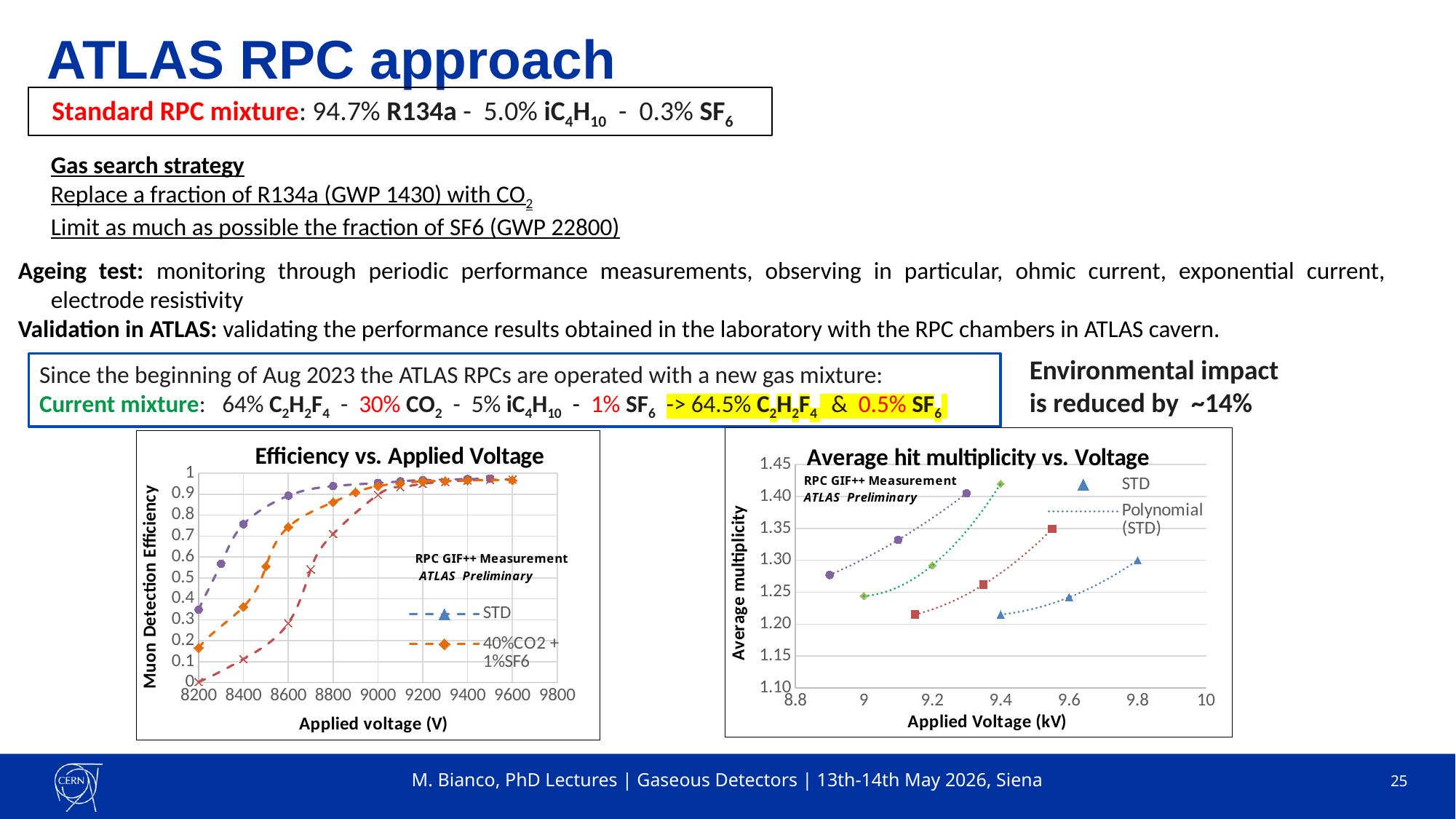
In the Efficiency vs. Applied Voltage chart, is the efficiency of the orange 40%CO2 + 1%SF6 series at 8600 V greater or less than 0.5? greater What is the title of the chart on the left of the slide? Efficiency vs. Applied Voltage What is the title of the chart on the right of the slide? Average hit multiplicity vs. Voltage In the Efficiency vs. Applied Voltage chart, is the efficiency of the orange 40%CO2 + 1%SF6 series at 8400 V greater or less than 0.5? less In the Average hit multiplicity vs. Voltage chart, is the red square series value at about 9.55 kV greater or less than 1.30? greater In the Efficiency vs. Applied Voltage chart, does the efficiency rise or fall as the applied voltage increases? rise In the Average hit multiplicity vs. Voltage chart, does the average multiplicity rise or fall as the applied voltage increases? rise In the Efficiency vs. Applied Voltage chart, what is the label of the y axis? Muon Detection Efficiency In the Average hit multiplicity vs. Voltage chart, how many entries does the legend list? 2